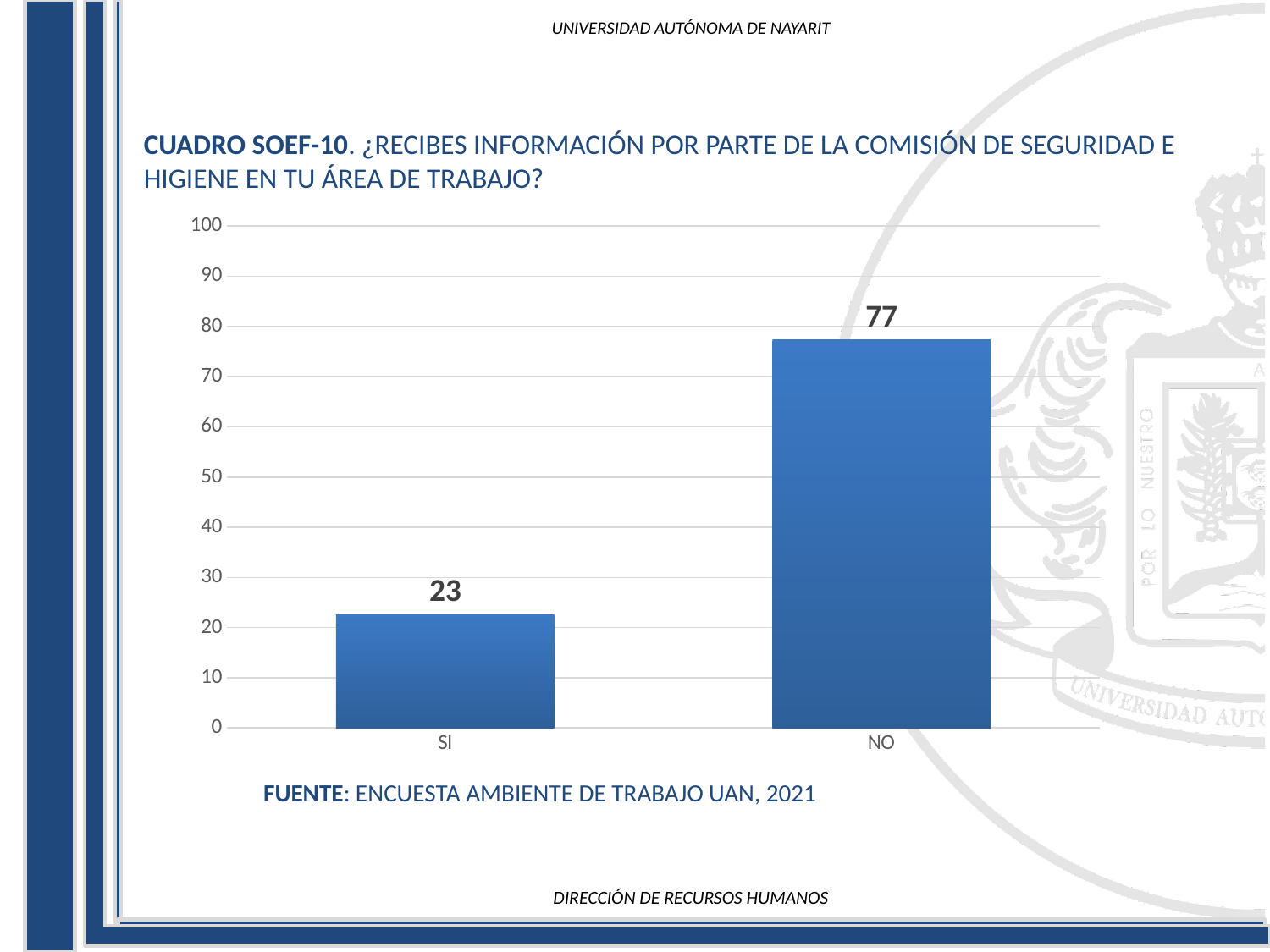
What is the difference between the values for NO and SI? 54 What is the value for SI? 23 Which category has the highest value? NO What kind of chart is shown on the slide? bar chart Is the value for NO greater or less than 70? greater Is the value for SI greater or less than 30? less Which is larger, the value for SI or the value for NO? NO How many categories are shown on the x axis? 2 What is the total of the two values shown in the chart? 100 Which category has the lowest value? SI What is the value for NO? 77 What is the source cited below the chart? ENCUESTA AMBIENTE DE TRABAJO UAN, 2021